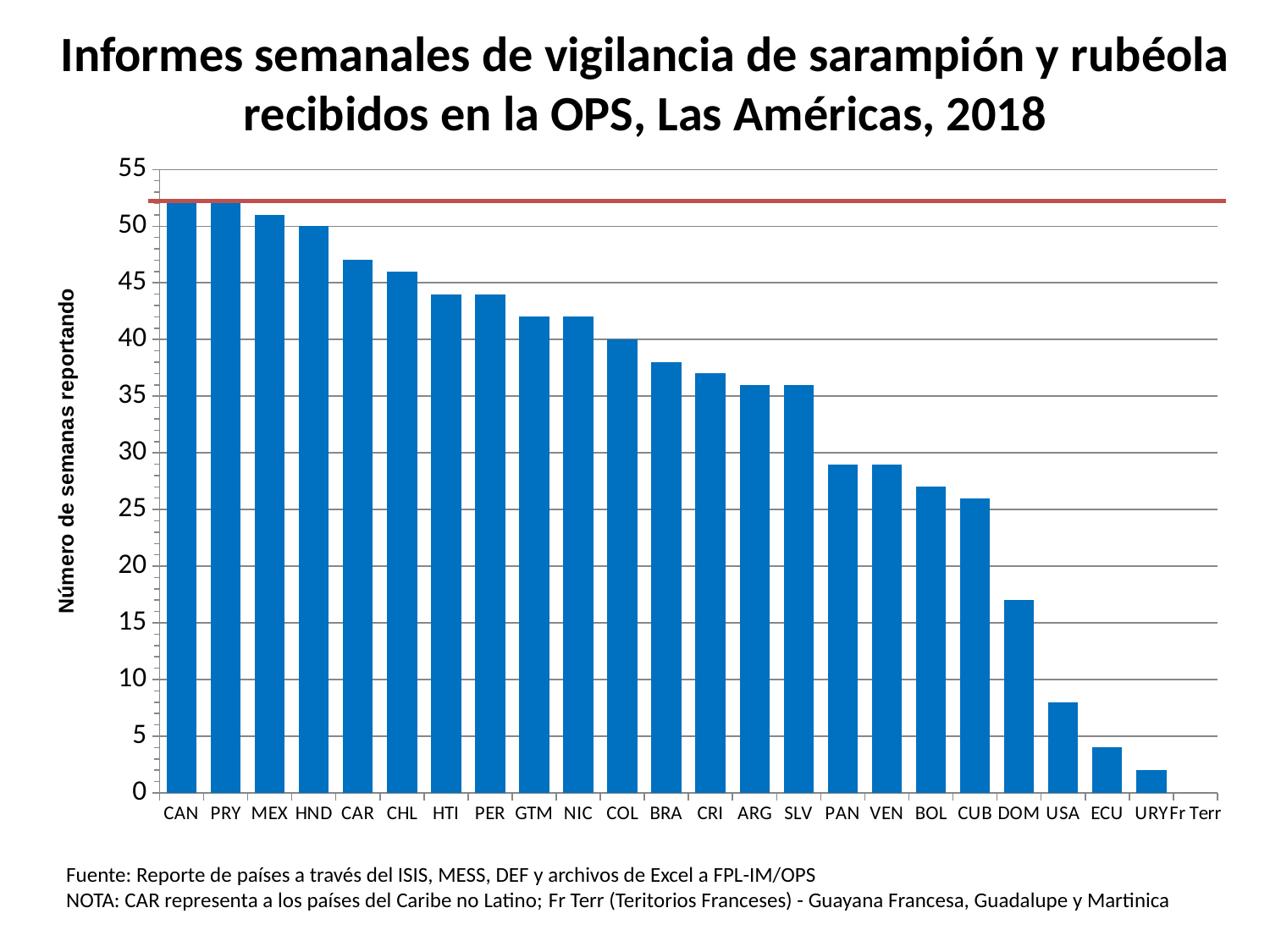
What kind of chart is shown on the slide? bar chart Which category has the lowest value? Fr Terr Is the value for DOM greater or less than 20? less Do the values rise or fall from left to right along the x axis? fall What is the value for COL? 40 Which has a larger value, CAN or USA? CAN How many countries or territories are shown on the x axis? 24 What is the label of the y axis? Número de semanas reportando What is the value for HND? 50 Is the value for USA greater or less than 10? less Is the value for CAR greater or less than 45? greater